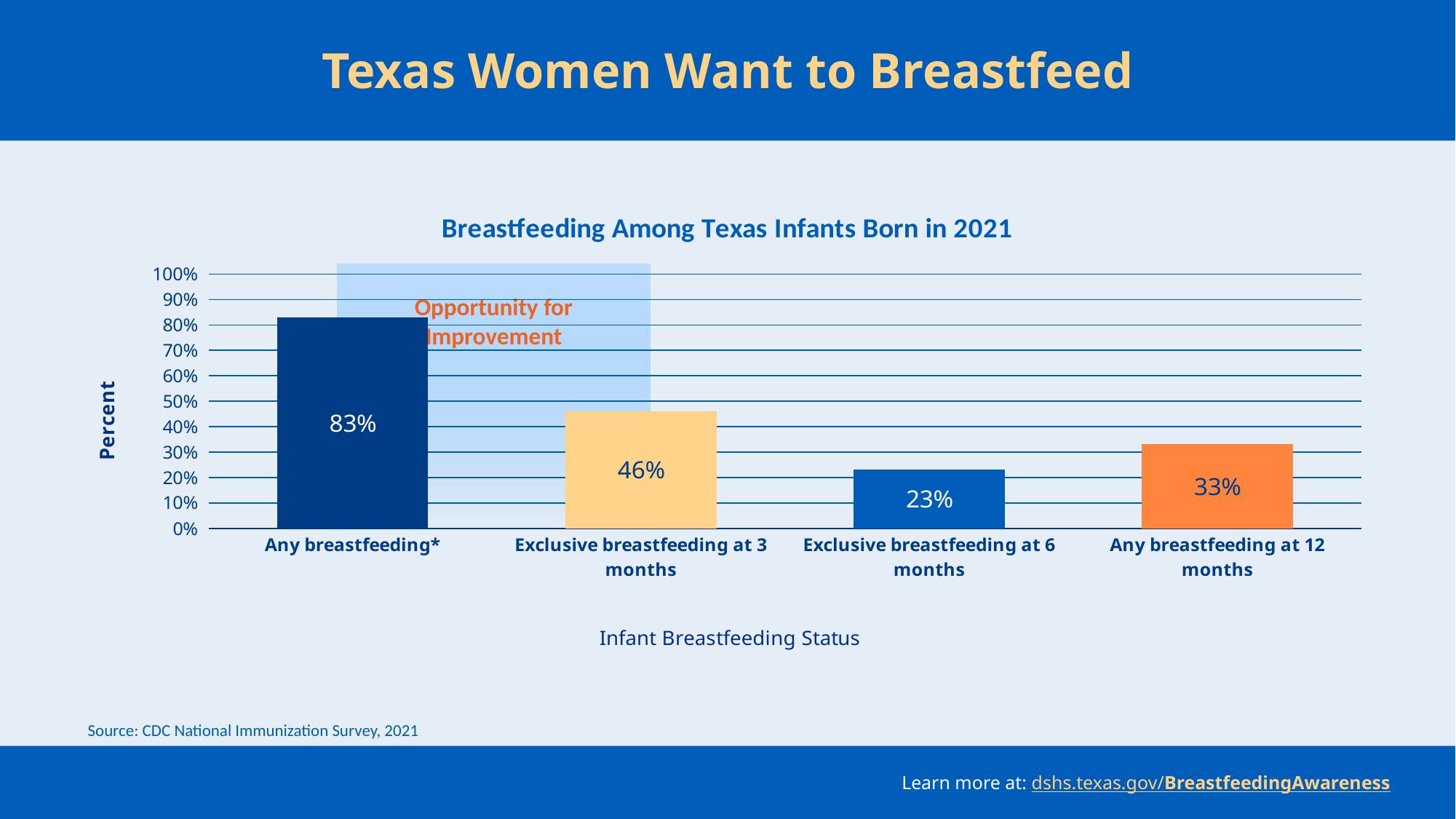
What is the value for Any breastfeeding at 12 months? 33% Which category has the lowest value? Exclusive breastfeeding at 6 months What is the value for Exclusive breastfeeding at 6 months? 23% What is the difference between Any breastfeeding at 12 months and Exclusive breastfeeding at 6 months? 10% What is the difference between Any breastfeeding* and Exclusive breastfeeding at 3 months? 37% How many categories are shown on the x axis? 4 What is the value for Any breastfeeding*? 83% What kind of chart is shown on the slide? Bar chart Which category has the highest value? Any breastfeeding* What is the value for Exclusive breastfeeding at 3 months? 46% What is the title of the chart? Breastfeeding Among Texas Infants Born in 2021 Which is larger, Exclusive breastfeeding at 3 months or Any breastfeeding at 12 months? Exclusive breastfeeding at 3 months